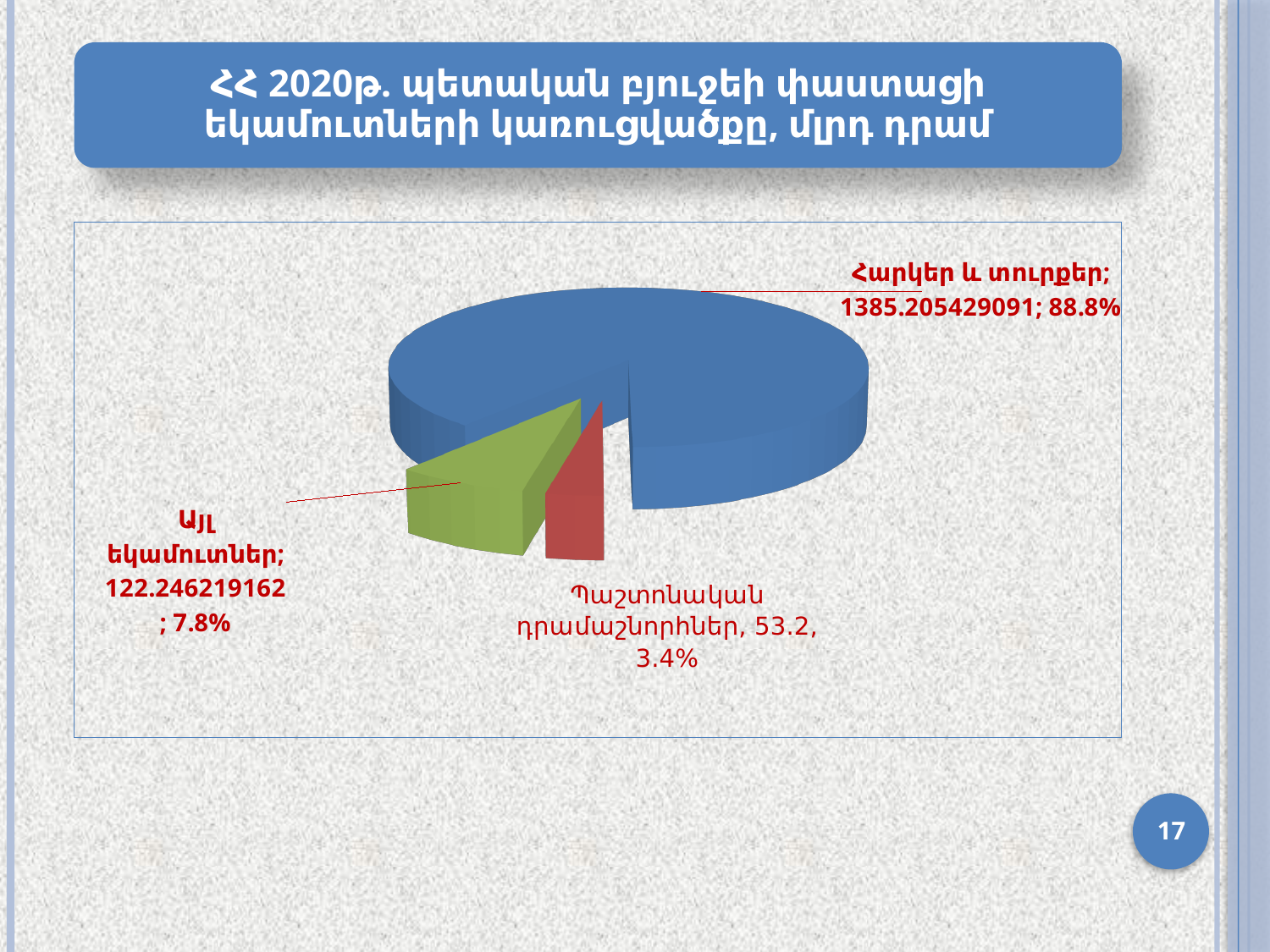
What kind of chart is shown on the slide? pie chart Which category has the largest slice of the pie? Հարկեր և տուրքեր What is the value shown for Այլ եկամուտներ? 122.246219162 What share of the pie does Պաշտոնական դրամաշնորհներ represent? 3.4% Which category has the smallest slice of the pie? Պաշտոնական դրամաշնորհներ What share of the pie does Հարկեր և տուրքեր represent? 88.8% What is the value shown for Հարկեր և տուրքեր? 1385.205429091 What share of the pie does Այլ եկամուտներ represent? 7.8% How many slices does the pie chart have? 3 Which is larger, the value for Այլ եկամուտներ or the value for Պաշտոնական դրամաշնորհներ? Այլ եկամուտներ What is the value shown for Պաշտոնական դրամաշնորհներ? 53.2 What is the difference in percentage share between Այլ եկամուտներ and Պաշտոնական դրամաշնորհներ? 4.4%